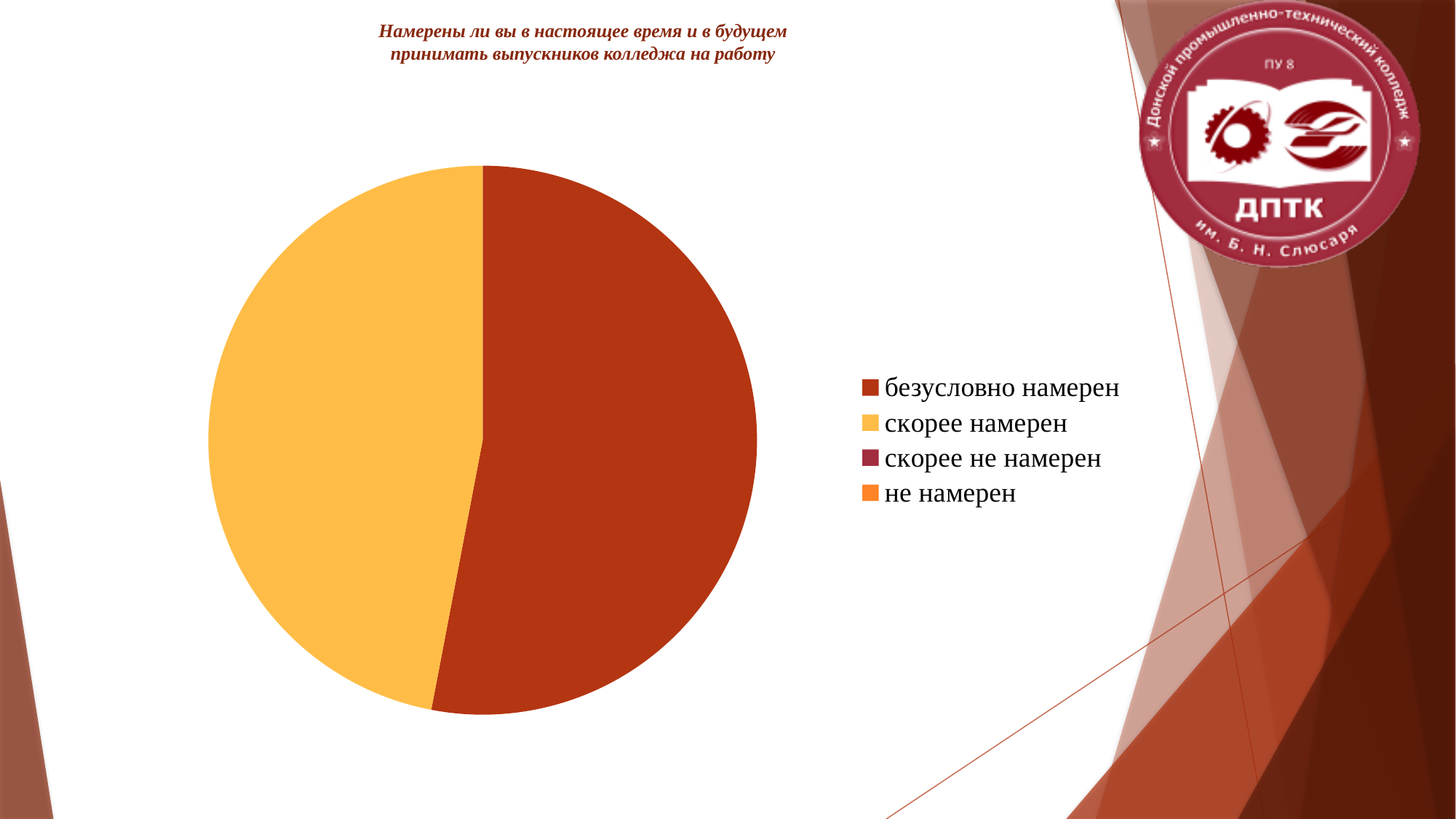
What is the title of the pie chart? Намерены ли вы в настоящее время и в будущем принимать выпускников колледжа на работу What kind of chart is shown on the slide? pie chart How many slices are visible in the pie chart? 2 What colour represents the category скорее намерен in the pie chart? yellow Which category has the largest slice in the pie chart? безусловно намерен Which legend entries have no visible slice in the pie chart? скорее не намерен, не намерен How many entries does the legend of the pie chart list? 4 Which slice is larger: безусловно намерен or скорее намерен? безусловно намерен